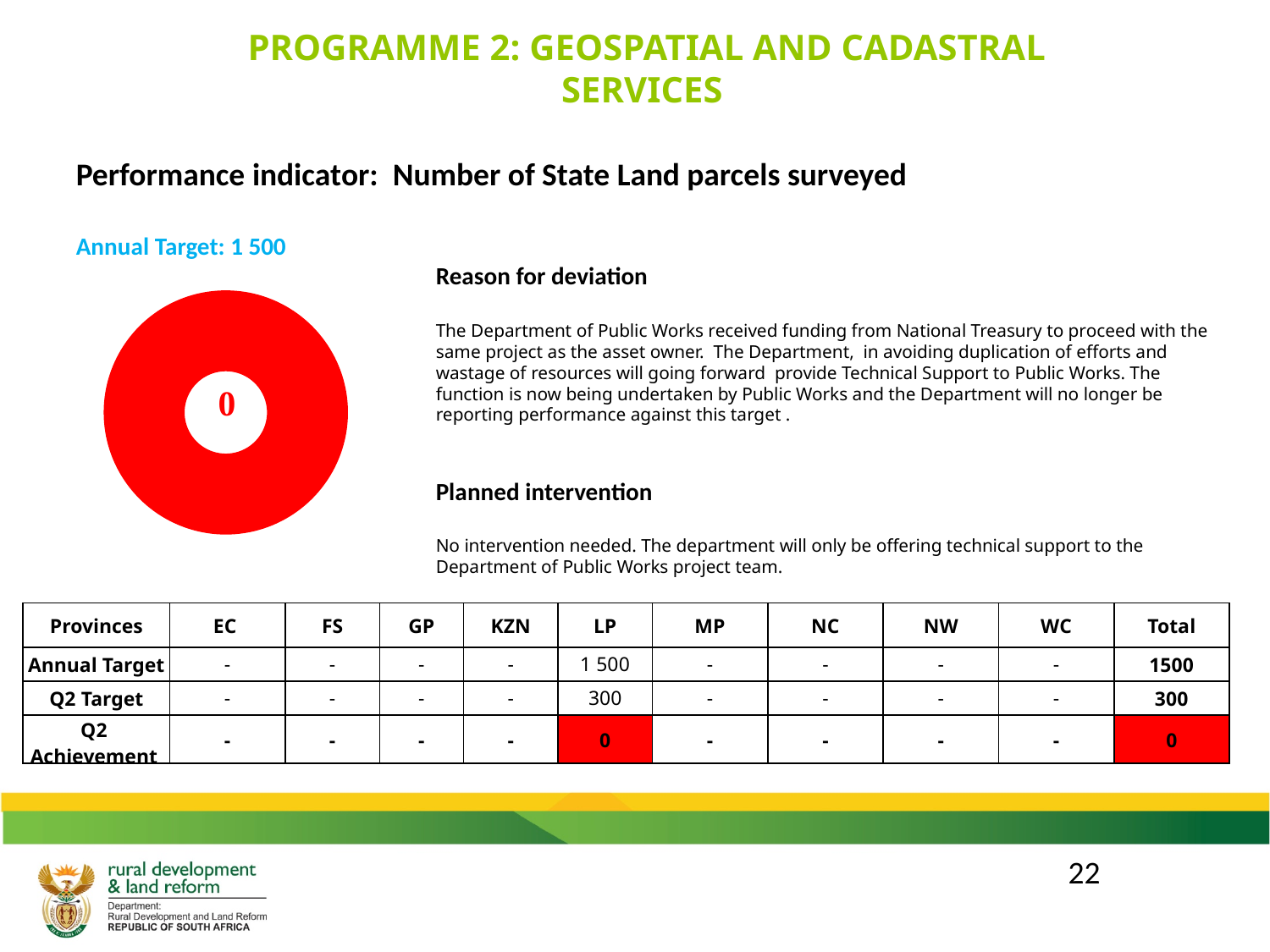
What kind of chart is shown on the left of the slide? doughnut chart What value is printed in the centre of the doughnut chart? 0 Is the value shown in the centre of the doughnut chart greater or less than 300? less What colour is the ring of the doughnut chart? red How many distinct coloured segments are visible in the doughnut chart? 1